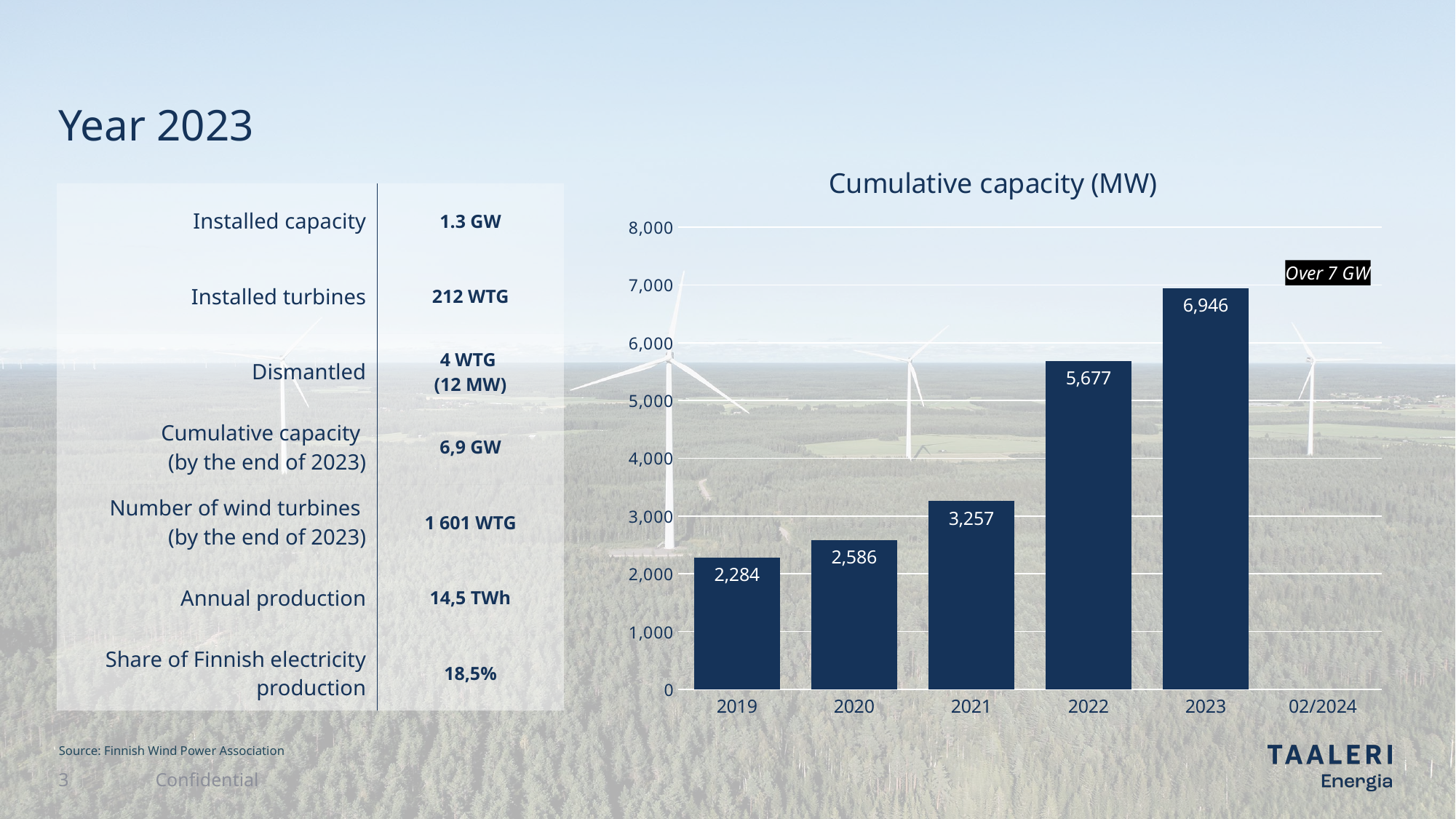
Which year has the highest cumulative capacity bar? 2023 What is the cumulative capacity shown for 2021? 3,257 What is the cumulative capacity shown for 2019? 2,284 What is the difference in cumulative capacity between 2020 and 2019? 302 What is the difference in cumulative capacity between 2023 and 2022? 1,269 What is the cumulative capacity shown for 2023? 6,946 Is the cumulative capacity for 2022 greater or less than 5,000? greater Which year has the lowest cumulative capacity bar? 2019 What kind of chart is used to show cumulative capacity? Bar chart How many bars are plotted in the Cumulative capacity chart? 5 Do the cumulative capacity values rise or fall from 2019 to 2023? Rise Which is larger, the cumulative capacity for 2022 or for 2021? 2022